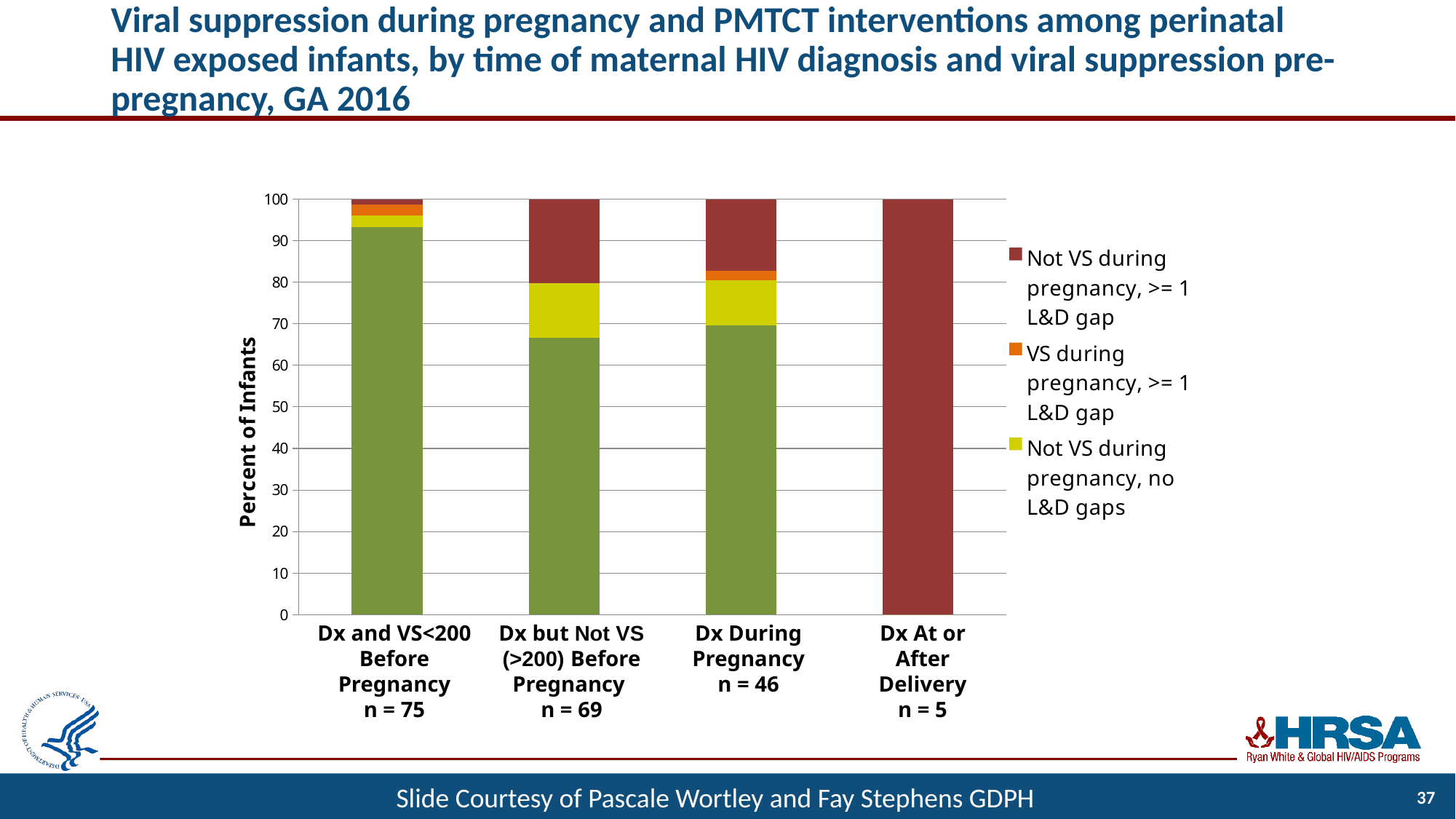
Which category has the smallest sample size (n)? Dx At or After Delivery What kind of chart is shown on the slide? Stacked bar chart What is the total height of the 'Dx At or After Delivery' stacked bar? 100 Which category has the largest green (bottom) segment? Dx and VS<200 Before Pregnancy Is the green (bottom) segment for 'Dx and VS<200 Before Pregnancy' greater or less than 90? greater How many series does the chart's legend list? 3 What is the sample size (n) shown for the 'Dx During Pregnancy' category? n = 46 Is the 'Not VS during pregnancy, >= 1 L&D gap' value for 'Dx At or After Delivery' greater or less than 90? greater Is the green (bottom) segment for 'Dx but Not VS (>200) Before Pregnancy' greater or less than 60? greater How many categories are shown along the x axis of the chart? 4 Which category has the largest 'Not VS during pregnancy, >= 1 L&D gap' segment? Dx At or After Delivery What is the label of the y axis? Percent of Infants